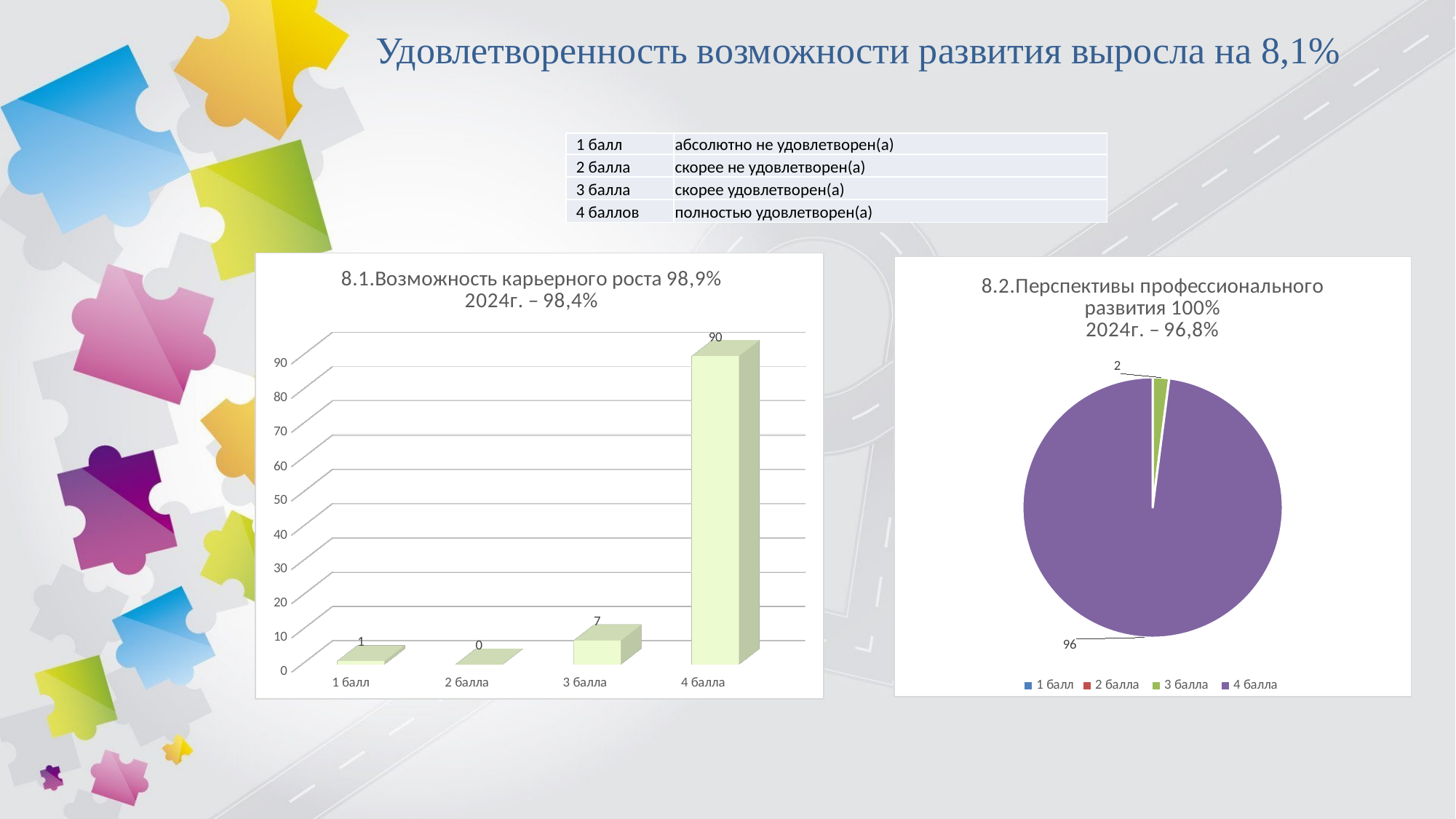
What kind of chart is '8.1.Возможность карьерного роста'? bar chart In the chart '8.1.Возможность карьерного роста', what is the value for 2 балла? 0 In the chart '8.1.Возможность карьерного роста', what is the value for 4 балла? 90 In the chart '8.1.Возможность карьерного роста', which category has the highest value? 4 балла In the pie chart '8.2.Перспективы профессионального развития', what is the value labelled for the 3 балла slice? 2 In the chart '8.1.Возможность карьерного роста', what is the value for 3 балла? 7 In the chart '8.1.Возможность карьерного роста', how many categories are shown on the x axis? 4 In the pie chart '8.2.Перспективы профессионального развития', how many entries does the legend list? 4 In the chart '8.1.Возможность карьерного роста', what is the difference between the values for 4 балла and 3 балла? 83 In the chart '8.1.Возможность карьерного роста', which category has the lowest value? 2 балла In the pie chart '8.2.Перспективы профессионального развития', what is the value labelled for the 4 балла slice? 96 What kind of chart is '8.2.Перспективы профессионального развития'? pie chart